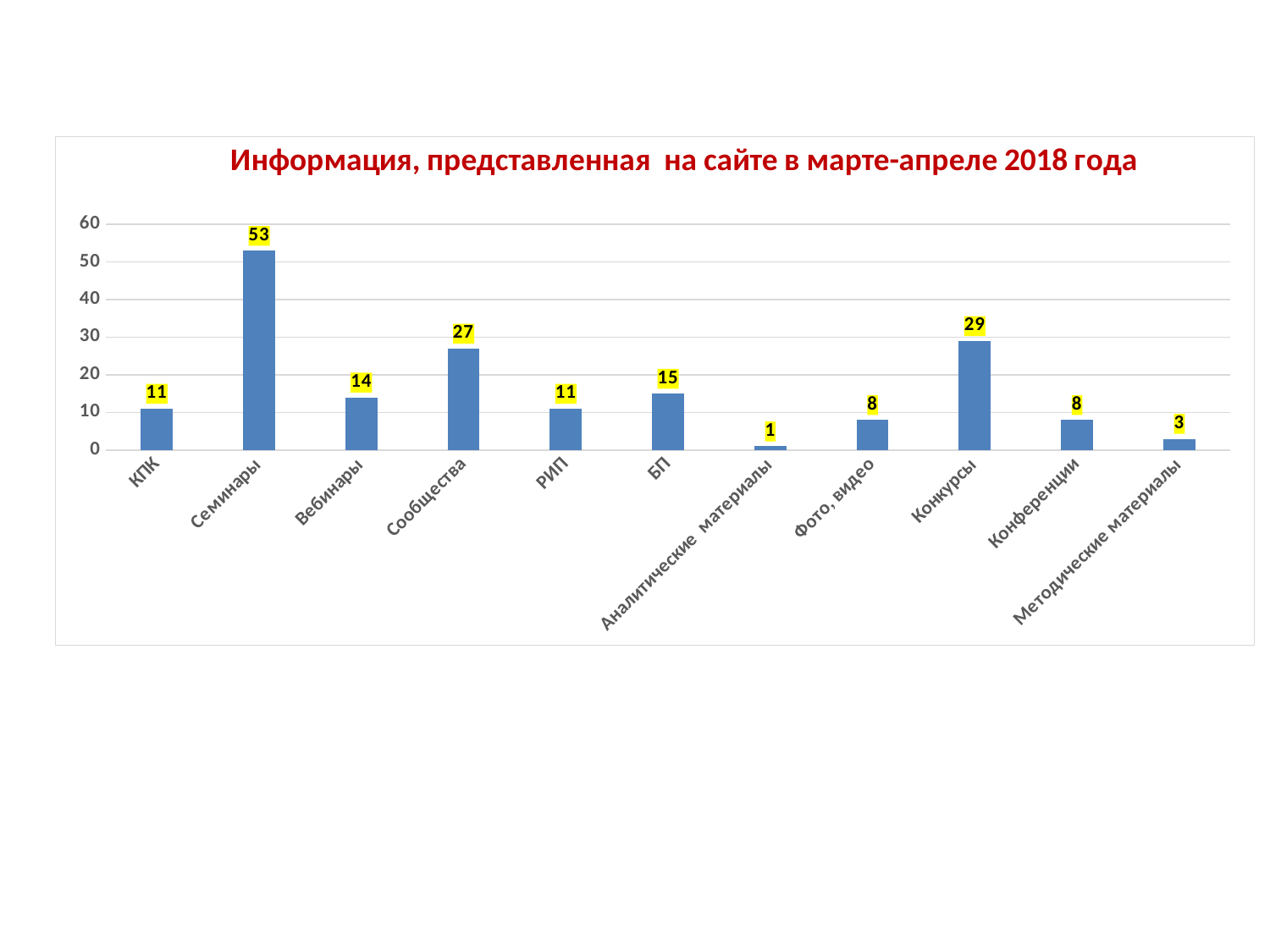
What is the title of the chart? Информация, представленная на сайте в марте-апреле 2018 года What is the value for Методические материалы? 3 What is the difference between the values for Семинары and Конкурсы? 24 What is the value for Семинары? 53 Which is larger, the value for Сообщества or the value for БП? Сообщества What is the value for Аналитические материалы? 1 Is the value for Вебинары greater or less than 20? less How many categories are shown on the x axis? 11 What is the value for Конкурсы? 29 Which category has the highest value? Семинары What kind of chart is this? bar chart Which category has the lowest value? Аналитические материалы